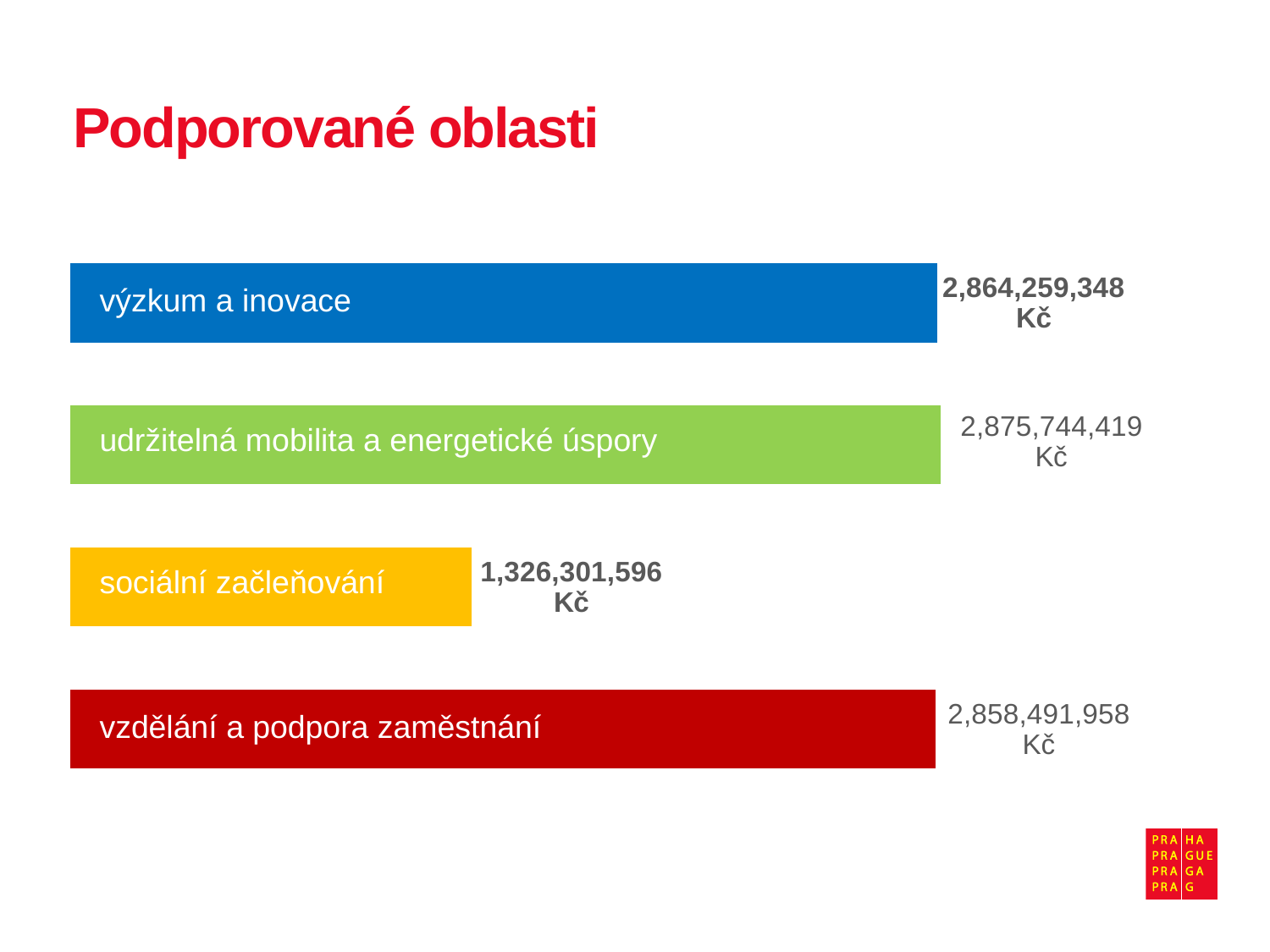
What kind of chart is shown on the slide? bar chart Which category has the lowest value? sociální začleňování What is the value for udržitelná mobilita a energetické úspory? 2,875,744,419 Kč What is the value for vzdělání a podpora zaměstnání? 2,858,491,958 Kč What is the value for výzkum a inovace? 2,864,259,348 Kč Which is larger, the value for výzkum a inovace or the value for sociální začleňování? výzkum a inovace What is the title of the slide? Podporované oblasti What is the value for sociální začleňování? 1,326,301,596 Kč What is the difference between the values for výzkum a inovace and sociální začleňování? 1,537,957,752 Kč How many categories are shown in the chart? 4 What is the difference between the values for udržitelná mobilita a energetické úspory and výzkum a inovace? 11,485,071 Kč Which category has the highest value? udržitelná mobilita a energetické úspory